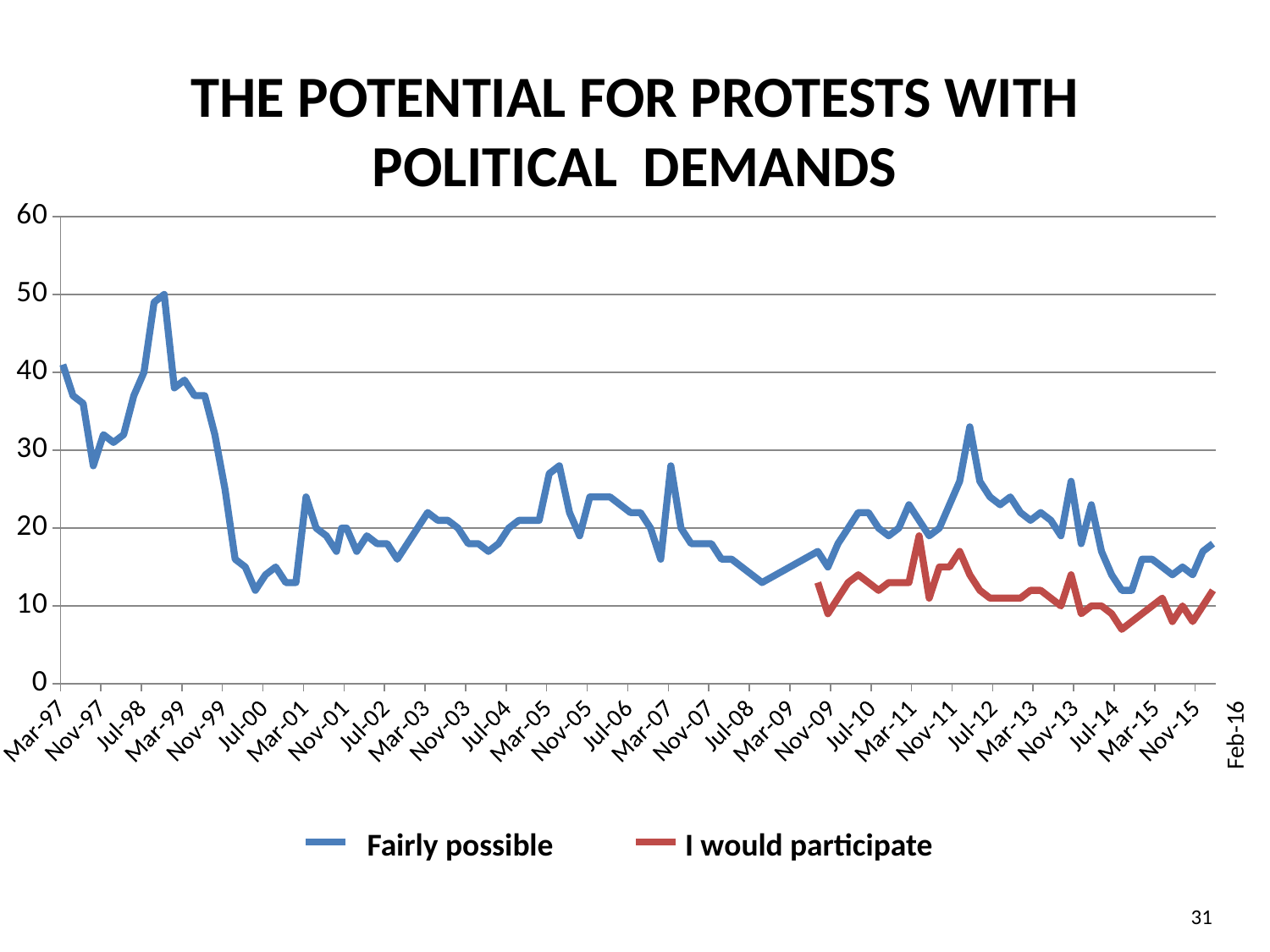
Is the peak value of the Fairly possible line greater or less than 40? greater What are the two series named in the legend? Fairly possible; I would participate Is the value for I would participate at Jul-14 greater or less than 10? less Overall, does the Fairly possible line rise or fall from Mar-97 to Feb-16? fall Which series has the higher value at Feb-16, Fairly possible or I would participate? Fairly possible How many series does the legend list? 2 What kind of chart is shown on the slide? line chart Which series begins later on the x axis? I would participate Is the value for Fairly possible at Jul-00 greater or less than 20? less What is the title of the chart? THE POTENTIAL FOR PROTESTS WITH POLITICAL DEMANDS Is the value for Fairly possible higher at Jul-98 or at Jul-00? Jul-98